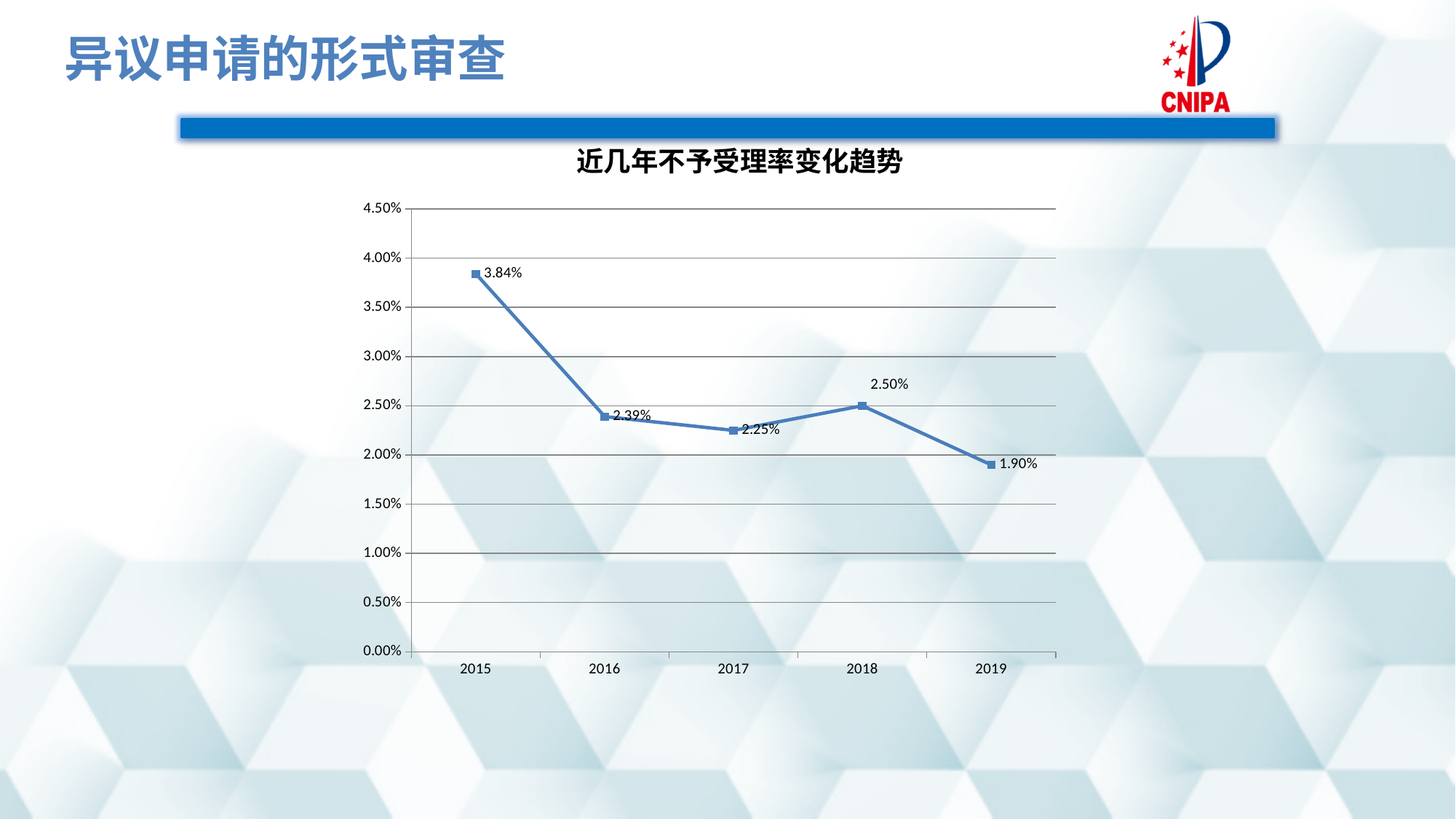
What kind of chart is shown on the slide? line chart What is the title of the chart? 近几年不予受理率变化趋势 What is the difference between the values for 2015 and 2019? 1.94% Which year has the highest value? 2015 What is the value for 2019? 1.90% What is the value for 2018? 2.50% What is the value for 2015? 3.84% Which is larger, the value for 2017 or the value for 2018? 2018 Is the value for 2016 greater or less than 3.00%? less Which year has the lowest value? 2019 What is the value for 2017? 2.25% How many years are plotted on the chart? 5